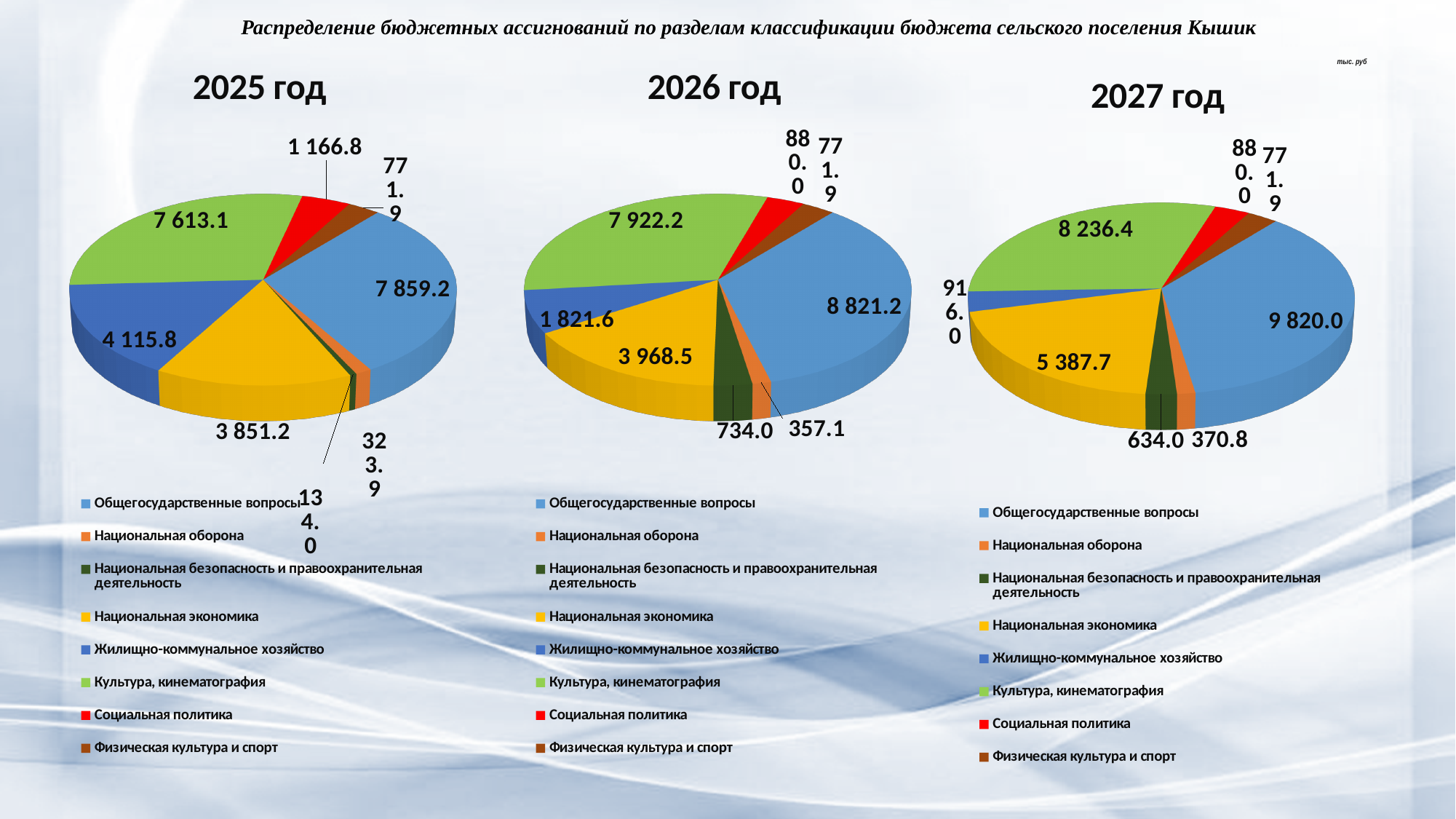
How many categories does the legend of the 2026 год chart list? 8 In the 2025 год chart, which category has the largest value? Общегосударственные вопросы In the 2026 год chart, what is the value for Национальная экономика? 3 968.5 What kind of chart is used for the 2025 год data? Pie chart In the 2025 год chart, which is larger: Жилищно-коммунальное хозяйство or Национальная экономика? Жилищно-коммунальное хозяйство In the 2026 год chart, what is the value for Жилищно-коммунальное хозяйство? 1 821.6 In the 2027 год chart, which category has the smallest value? Национальная оборона How many pie charts are shown on the slide? 3 In the 2027 год chart, what is the value for Культура, кинематография? 8 236.4 In the 2027 год chart, what is the value for Национальная безопасность и правоохранительная деятельность? 634.0 In the 2026 год chart, what is the difference between Общегосударственные вопросы and Культура, кинематография? 899.0 In the 2025 год chart, what is the value for Общегосударственные вопросы? 7 859.2